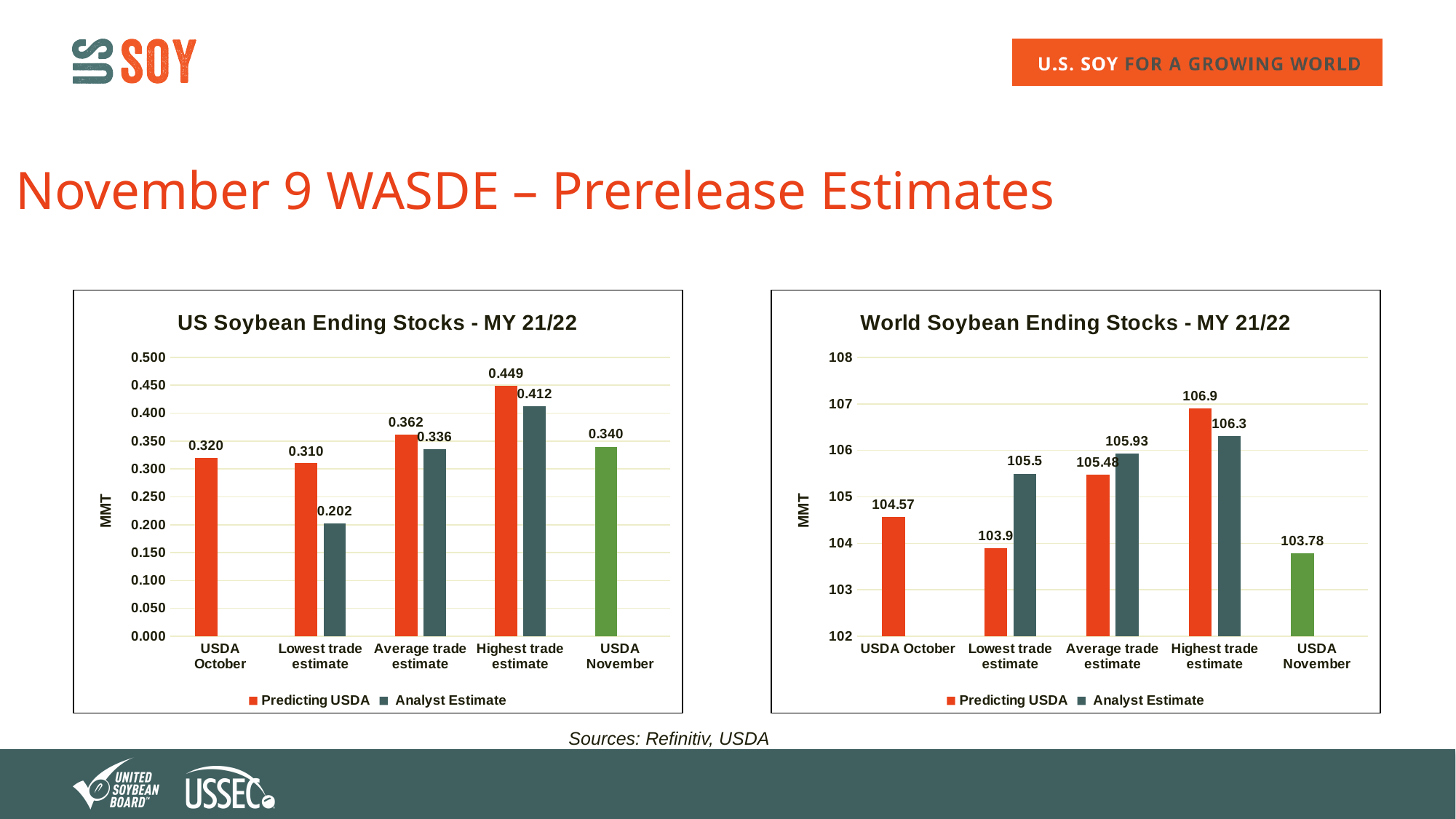
In the World Soybean Ending Stocks chart, what is the Analyst Estimate value for the Average trade estimate? 105.93 In the US Soybean Ending Stocks chart, what is the value shown for USDA November? 0.340 In the US Soybean Ending Stocks chart, what is the Predicting USDA value for the Highest trade estimate? 0.449 In the World Soybean Ending Stocks chart, what is the difference between the USDA October value and the USDA November value? 0.79 In the US Soybean Ending Stocks chart, what is the difference between the Predicting USDA and Analyst Estimate values for the Average trade estimate? 0.026 How many series does the legend of the World Soybean Ending Stocks chart list? 2 In the World Soybean Ending Stocks chart, is the value for USDA November greater or less than 104? less In the US Soybean Ending Stocks chart, what is the Analyst Estimate value for the Lowest trade estimate? 0.202 In the World Soybean Ending Stocks chart, what is the value for USDA October? 104.57 In the World Soybean Ending Stocks chart, which is larger for the Highest trade estimate: Predicting USDA or Analyst Estimate? Predicting USDA What kind of chart is the US Soybean Ending Stocks chart? Bar chart In the US Soybean Ending Stocks chart, which category has the lowest plotted value? Lowest trade estimate